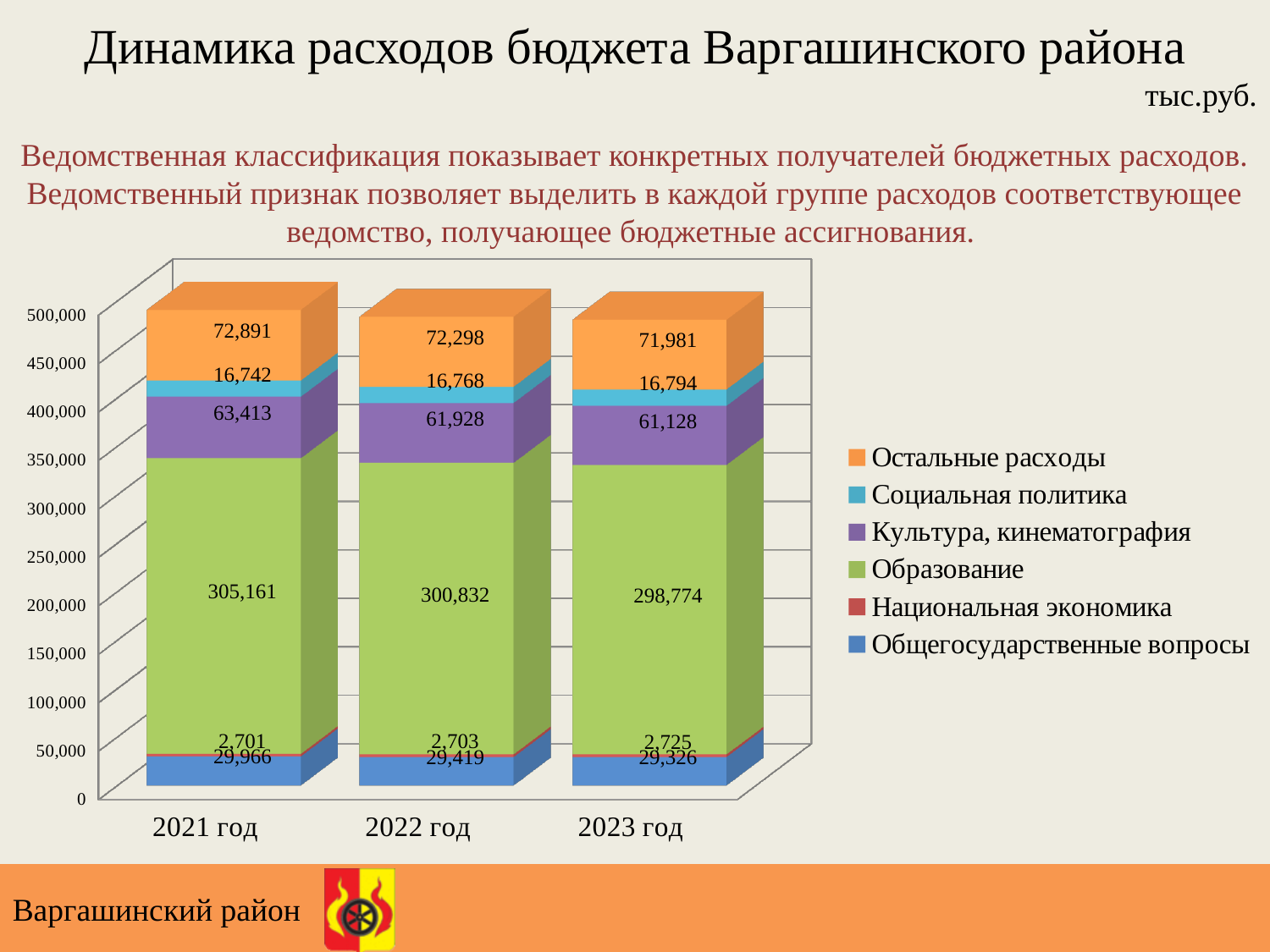
What kind of chart is shown on the slide? Stacked bar chart Which is larger: Социальная политика in 2021 год or in 2023 год? 2023 год What is the value for Остальные расходы in 2023 год? 71,981 How many years are shown on the x axis? 3 In which year is the value for Образование the highest? 2021 год What is the value for Образование in 2021 год? 305,161 How many series does the legend list? 6 What is the difference between the Образование values for 2021 год and 2023 год? 6,387 What is the total of the stacked bar for 2021 год? 490,874 Which series has the smallest value in 2023 год? Национальная экономика What is the value for Общегосударственные вопросы in 2022 год? 29,419 What is the value for Культура, кинематография in 2022 год? 61,928